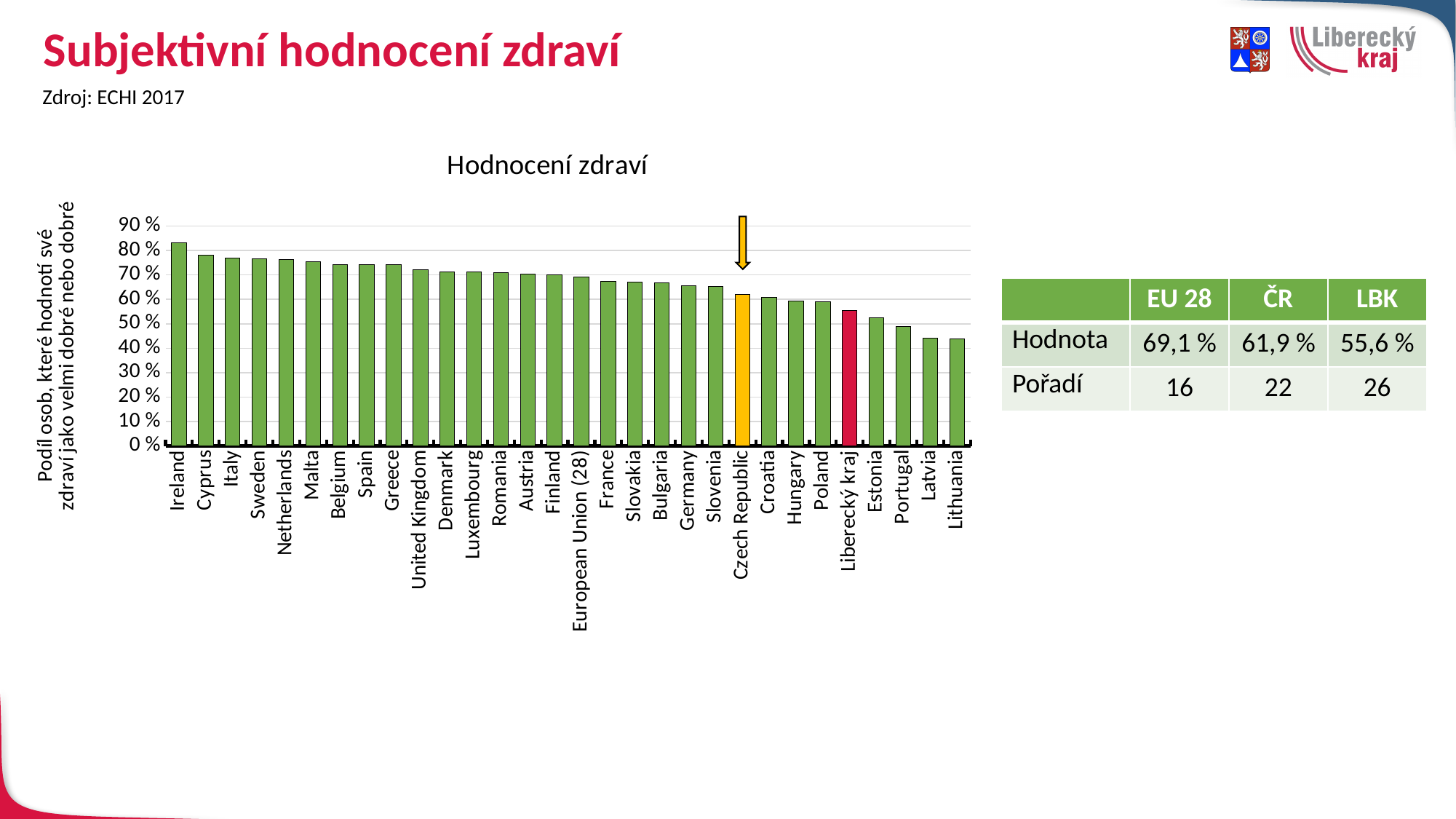
Which is larger, the value for the Czech Republic or the value for Liberecký kraj? Czech Republic What is the value for the Czech Republic according to the slide? 61,9 % Do the values rise or fall from left to right along the x axis? fall What kind of chart is shown on the slide? bar chart What is the value for European Union (28) according to the slide? 69,1 % Which country has the highest value in the chart? Ireland What is the difference between the EU 28 value and the Czech Republic value? 7,2 % Is the value for Ireland greater or less than 80 %? greater What is the value for Liberecký kraj (LBK) according to the slide? 55,6 % What is the title of the chart? Hodnocení zdraví Is the value for Latvia greater or less than 50 %? less How many countries/regions are shown on the x axis of the chart? 30